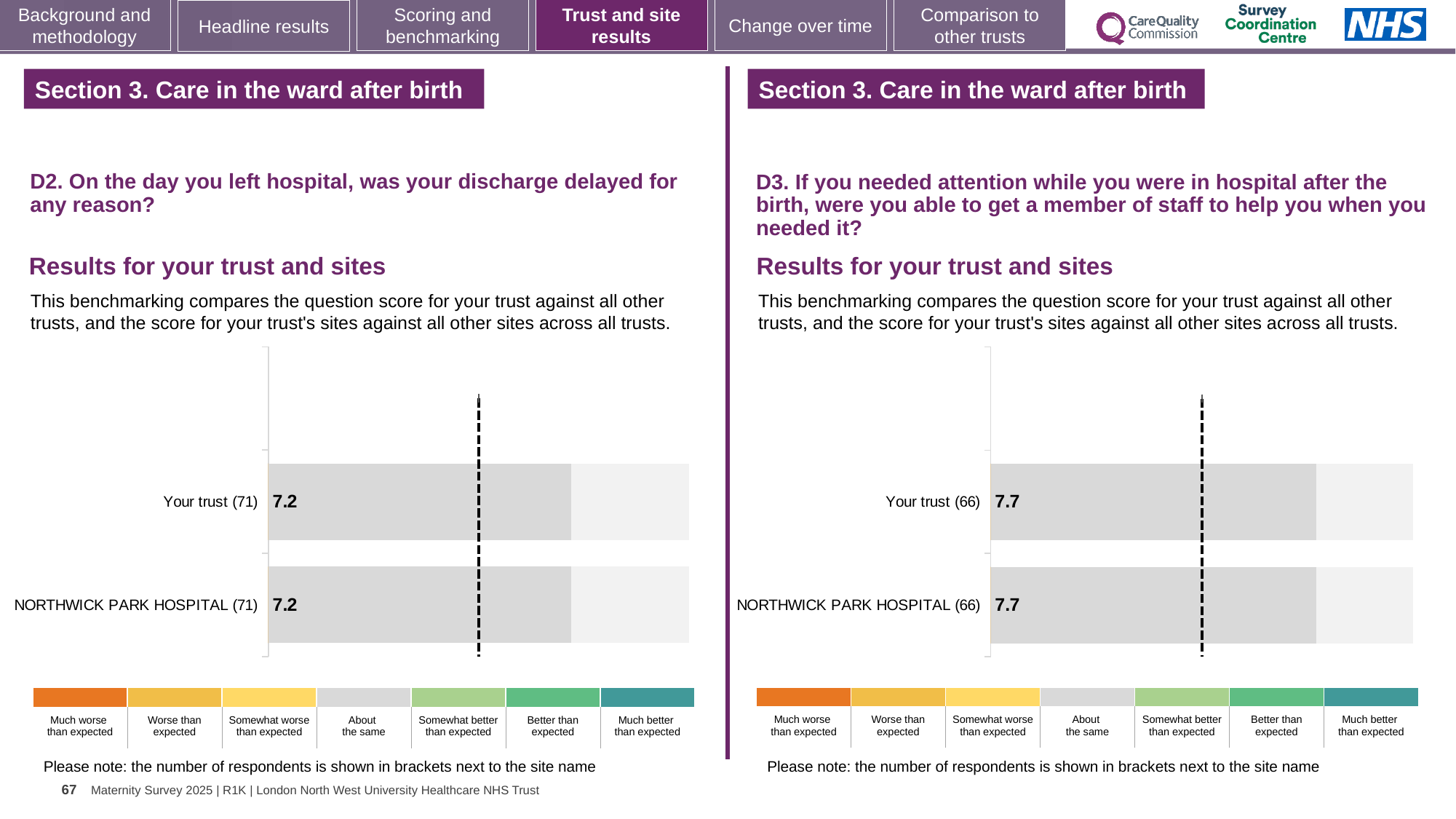
How many bars are plotted in the D3 chart on the right? 2 Is the score for Your trust in the D3 chart on the right larger or smaller than the score for Your trust in the D2 chart on the left? Larger In the D2 chart on the left, what is the score for Your trust? 7.2 In the D3 chart on the right, what is the score for NORTHWICK PARK HOSPITAL? 7.7 In the D3 chart on the right, what is the score for Your trust? 7.7 In the D3 chart on the right, how many respondents are shown in brackets next to NORTHWICK PARK HOSPITAL? 66 In the D2 chart on the left, what is the difference between the score for Your trust and the score for NORTHWICK PARK HOSPITAL? 0 In the D2 chart on the left, how many respondents are shown in brackets next to Your trust? 71 In the D3 chart on the right, what is the difference between the score for Your trust and the score for NORTHWICK PARK HOSPITAL? 0 How many bars are plotted in the D2 chart on the left? 2 What kind of chart is the D2 chart on the left? Bar chart In the D2 chart on the left, what is the score for NORTHWICK PARK HOSPITAL? 7.2